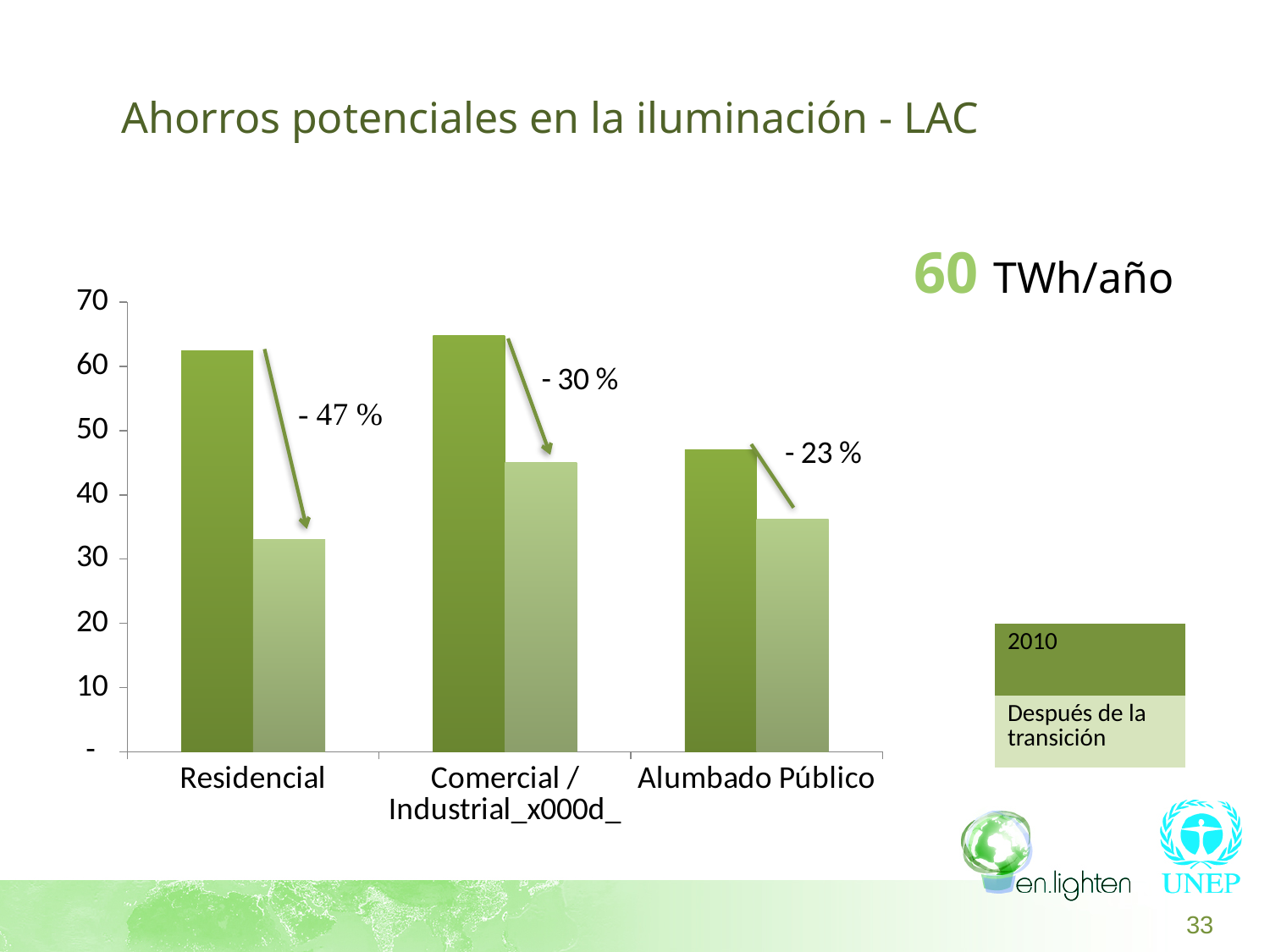
Is the 2010 value for Residencial greater or less than 60? greater What is the title of the slide containing the chart? Ahorros potenciales en la iluminación - LAC What percentage reduction is annotated for Alumbado Público? - 23 % Is the 'Después de la transición' value for Residencial greater or less than 40? less What kind of chart is shown on the slide? bar chart Is the 2010 value for Alumbado Público greater or less than 50? less Which category shows the larger percentage reduction, Residencial or Alumbado Público? Residencial How many categories are shown on the x axis of the chart? 3 What percentage reduction is annotated for Residencial? - 47 % Which category has the lowest 2010 value? Alumbado Público How many series does the legend list? 2 What percentage reduction is annotated for Comercial / Industrial? - 30 %